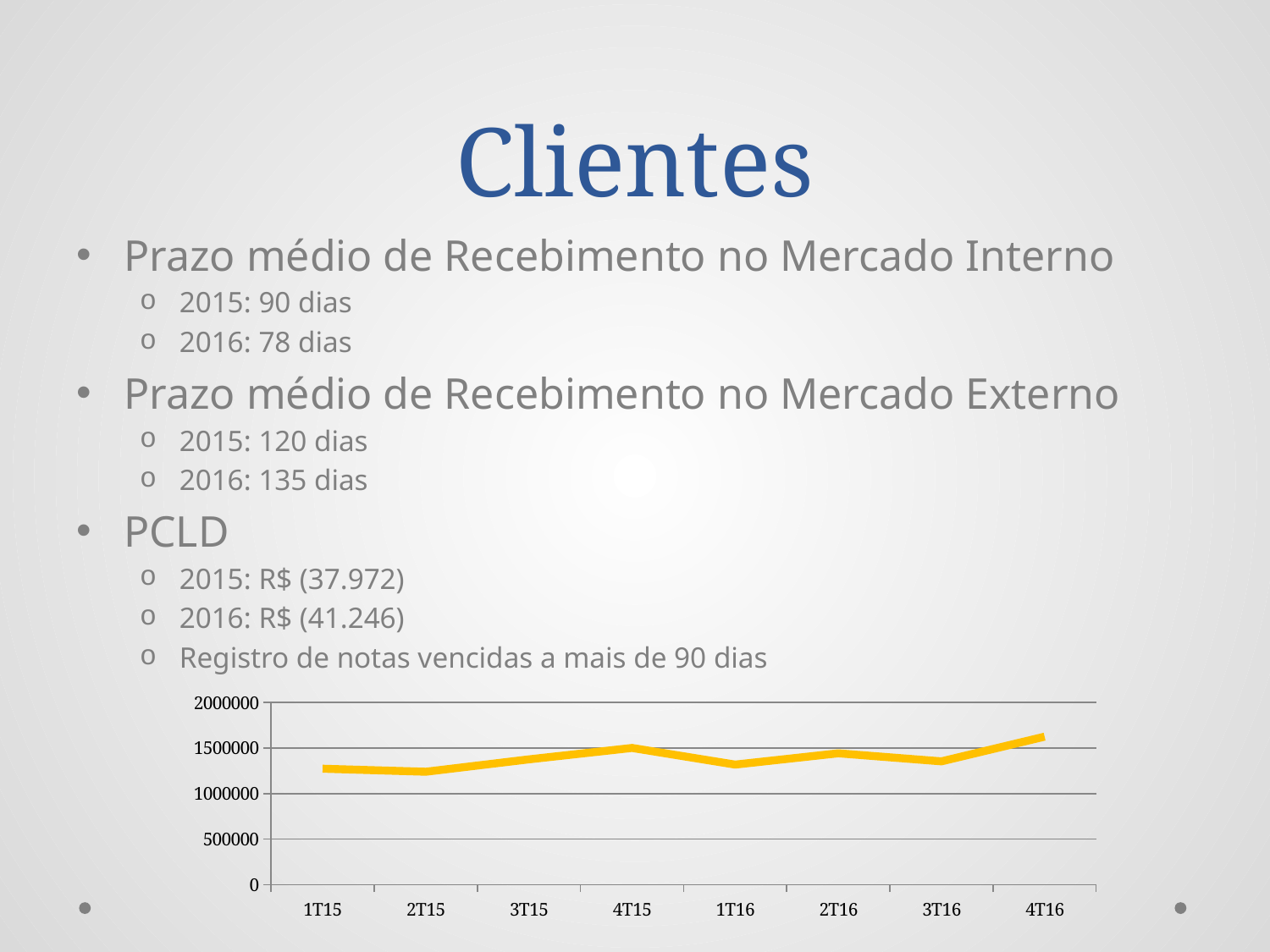
Is the value for 3T16 greater or less than 1500000? less Is the value for 2T15 greater or less than 1000000? greater What kind of chart is shown at the bottom of the slide? line chart How many quarters are plotted along the x axis of the chart? 8 Which is larger, the value for 1T15 or the value for 4T16? 4T16 Is the value for 1T15 greater or less than 1500000? less Which quarter has the highest value on the chart? 4T16 Which is larger, the value for 2T15 or the value for 3T15? 3T15 What colour is the line plotted on the chart? yellow Overall, does the line rise or fall from 1T15 to 4T16? rise Which is larger, the value for 4T15 or the value for 1T16? 4T15